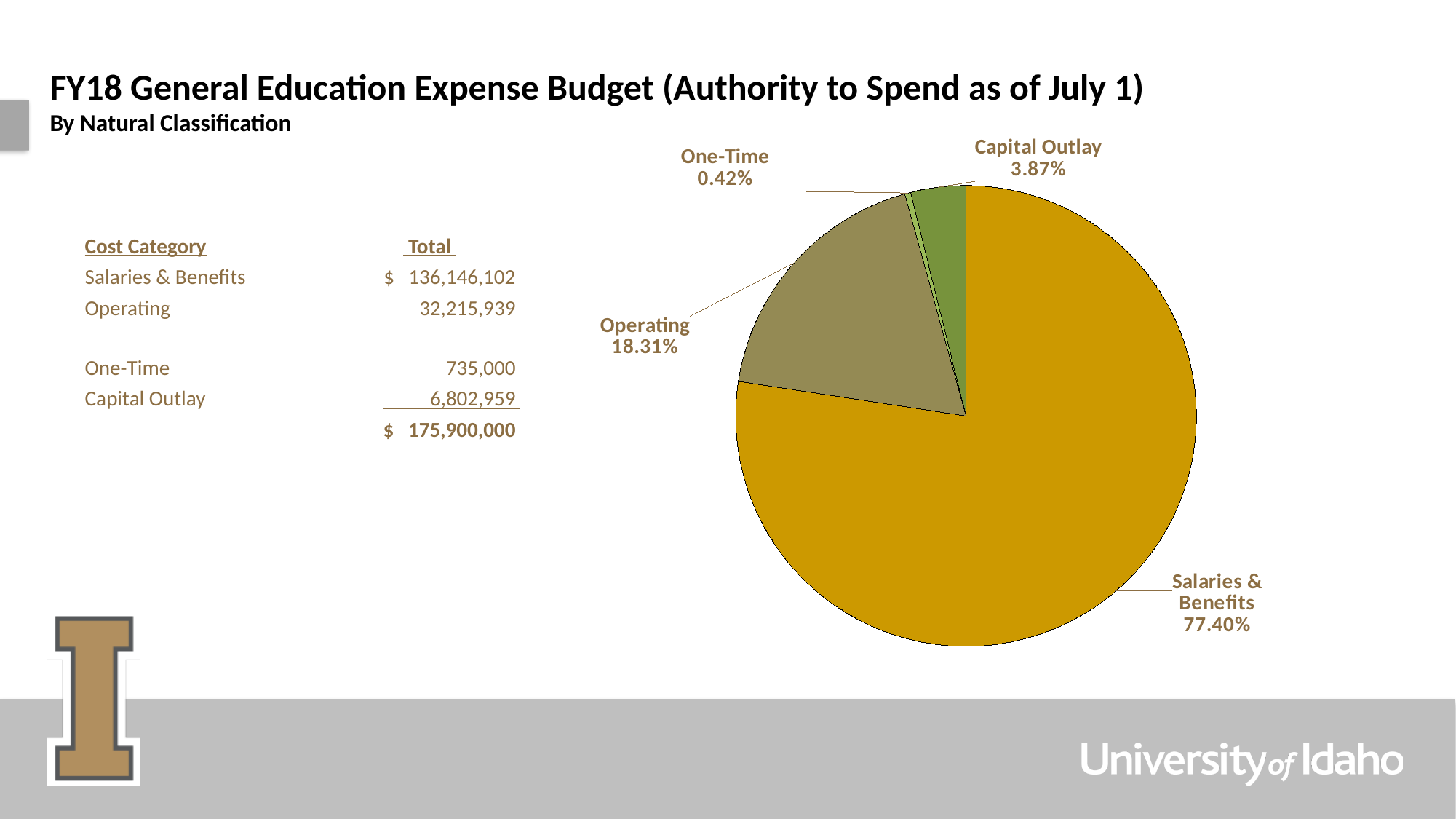
Which slice is larger, Operating or Capital Outlay? Operating Which category has the smallest slice of the pie? One-Time What is the difference in percentage points between the Salaries & Benefits slice and the Operating slice? 59.09% What share of the pie does Operating represent? 18.31% What share of the pie does Salaries & Benefits represent? 77.40% Which category has the largest slice of the pie? Salaries & Benefits What share of the pie does Capital Outlay represent? 3.87% What kind of chart is shown on the slide? pie chart Is the share for Salaries & Benefits greater or less than 75%? greater How many slices does the pie chart have? 4 What colour is the Salaries & Benefits slice? gold